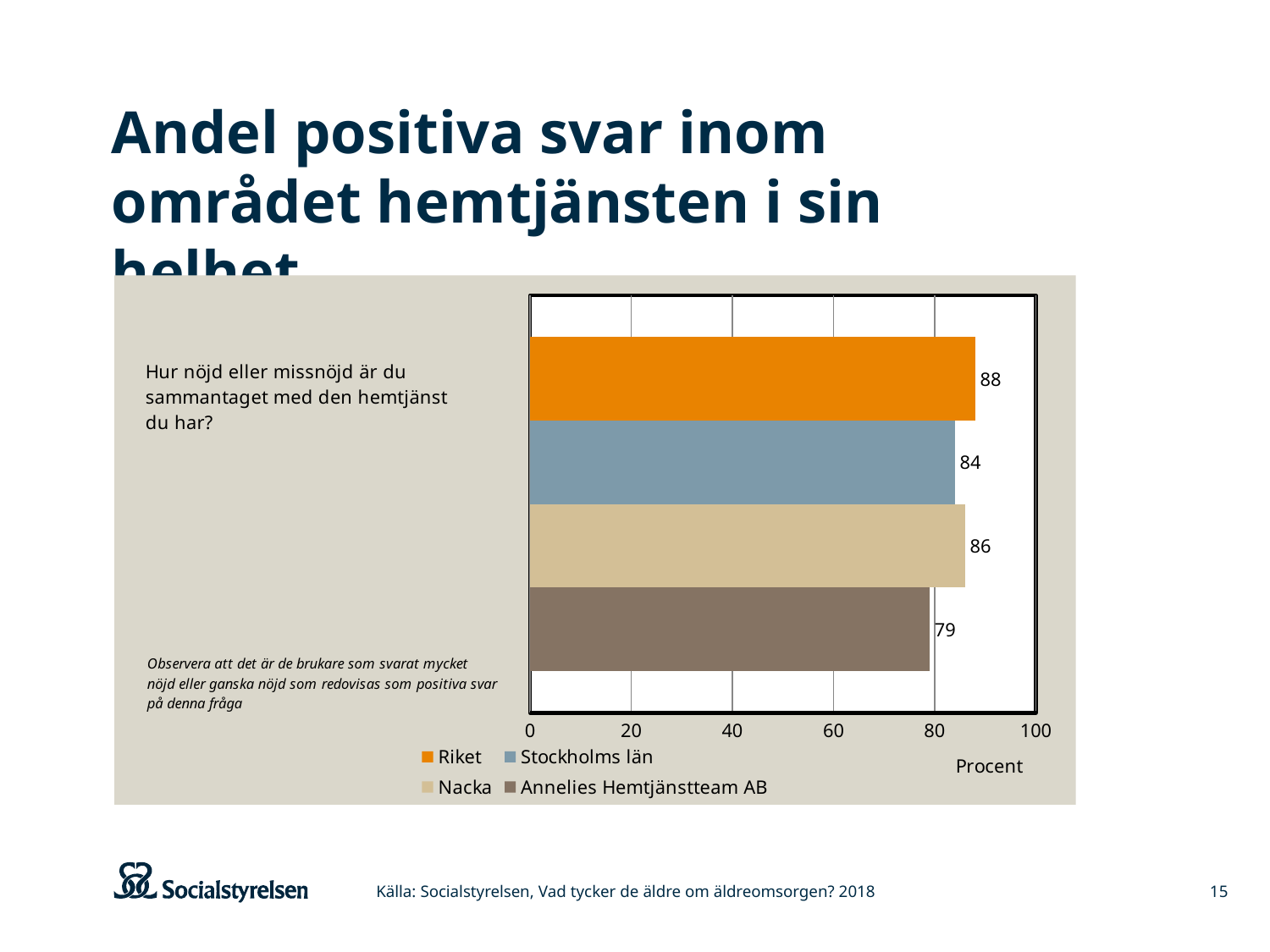
What is the value for Nacka? 86 What is the difference between the values for Riket and Annelies Hemtjänstteam AB? 9 What is the label of the horizontal axis? Procent What kind of chart is shown on the slide? Bar chart What is the value for Annelies Hemtjänstteam AB? 79 What is the value for Riket? 88 What is the difference between the values for Nacka and Stockholms län? 2 How many series does the legend list? 4 Which series has the highest value? Riket Which series has the lowest value? Annelies Hemtjänstteam AB Which is larger, the value for Nacka or the value for Stockholms län? Nacka What is the value for Stockholms län? 84